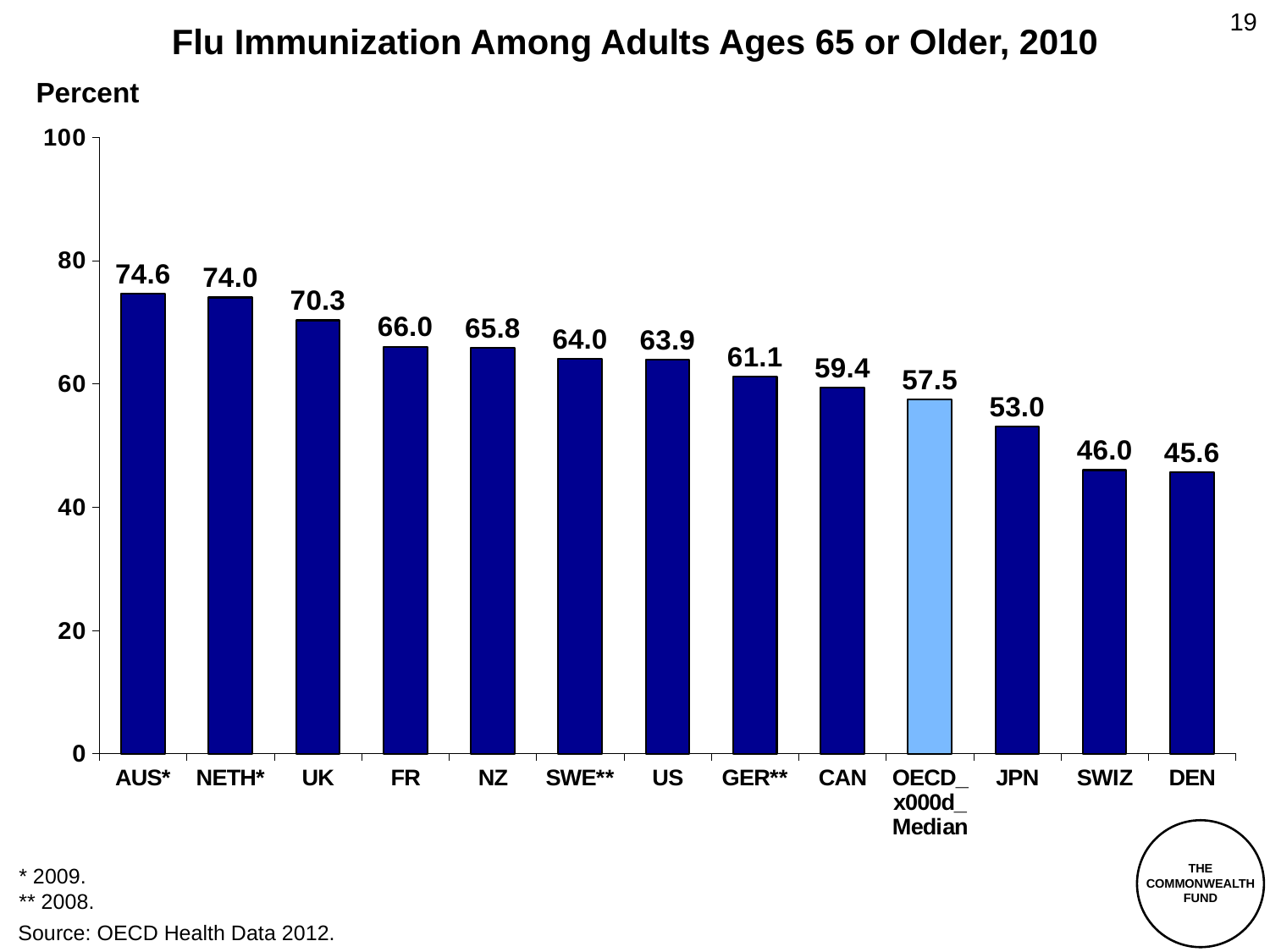
Which country has the highest flu immunization rate on the chart? AUS* What is the value shown for the OECD Median bar? 57.5 What is the difference between the US value and the OECD Median? 6.4 What kind of chart is shown on the slide? bar chart Is the value for JPN greater or less than 60? less What is the value for CAN? 59.4 Which country has the lowest flu immunization rate on the chart? DEN What is the flu immunization rate for the UK? 70.3 What is the difference between the values for AUS* and DEN? 29.0 How many bars are shown on the chart? 13 Which bar is shown in a lighter blue colour than the others? OECD Median Which has a higher value, FR or GER**? FR